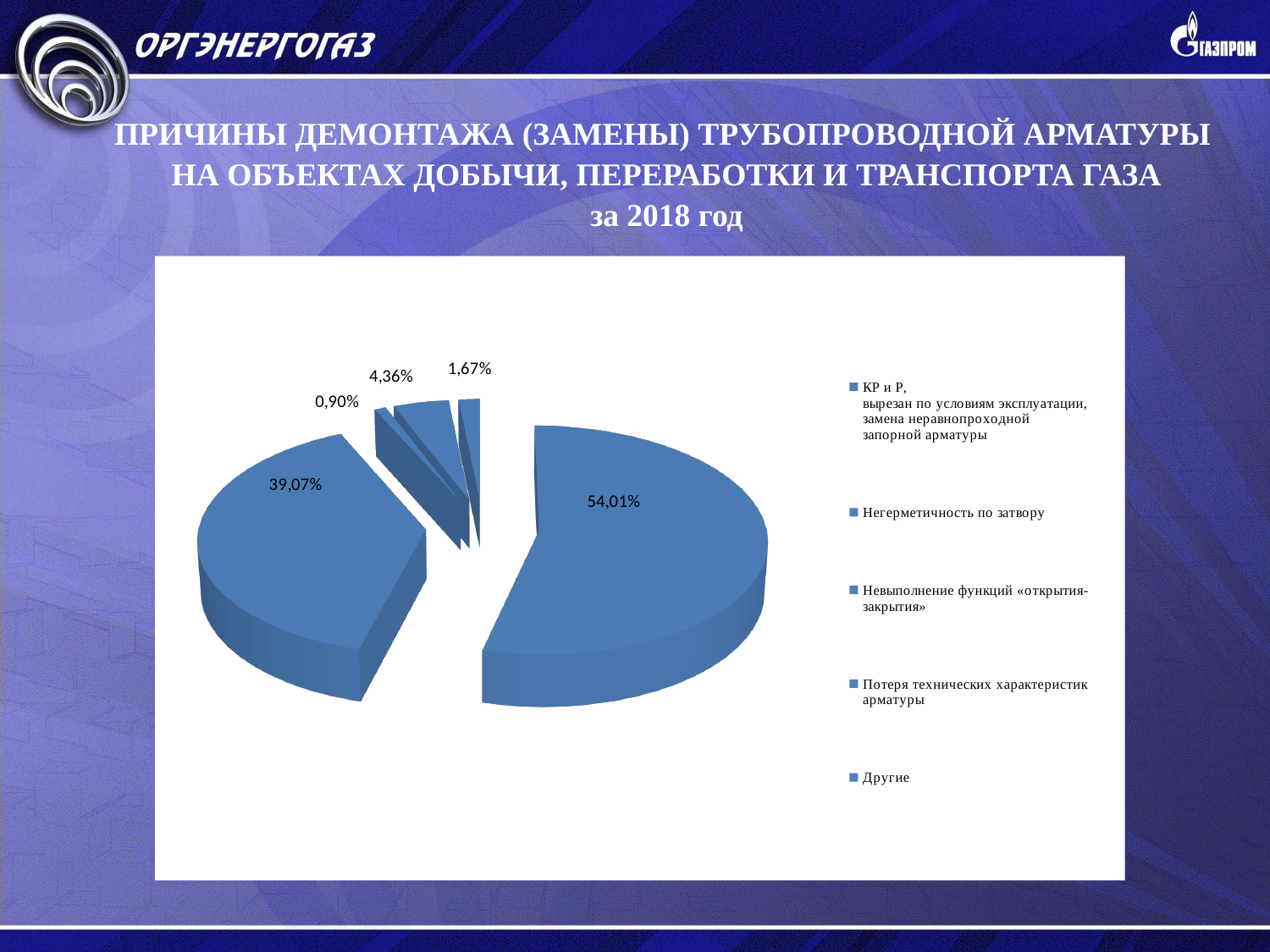
What is the last entry listed in the chart legend? Другие Which is larger in the pie chart: the slice labelled 4,36% or the slice labelled 1,67%? 4,36% How many entries does the legend of the pie chart list? 5 What is the value of the second-largest slice in the pie chart? 39,07% What is the combined share of the three smallest slices (0,90%, 4,36% and 1,67%) in the pie chart? 6,93% Is the largest slice of the pie chart greater or less than 50%? greater What is the value of the largest slice in the pie chart? 54,01% What is the value of the smallest slice in the pie chart? 0,90% What kind of chart is shown on the slide? pie chart How many slices does the pie chart have? 5 What is the difference between the two largest slices of the pie chart (54,01% and 39,07%)? 14,94% Which year does the chart title say the data is for? 2018